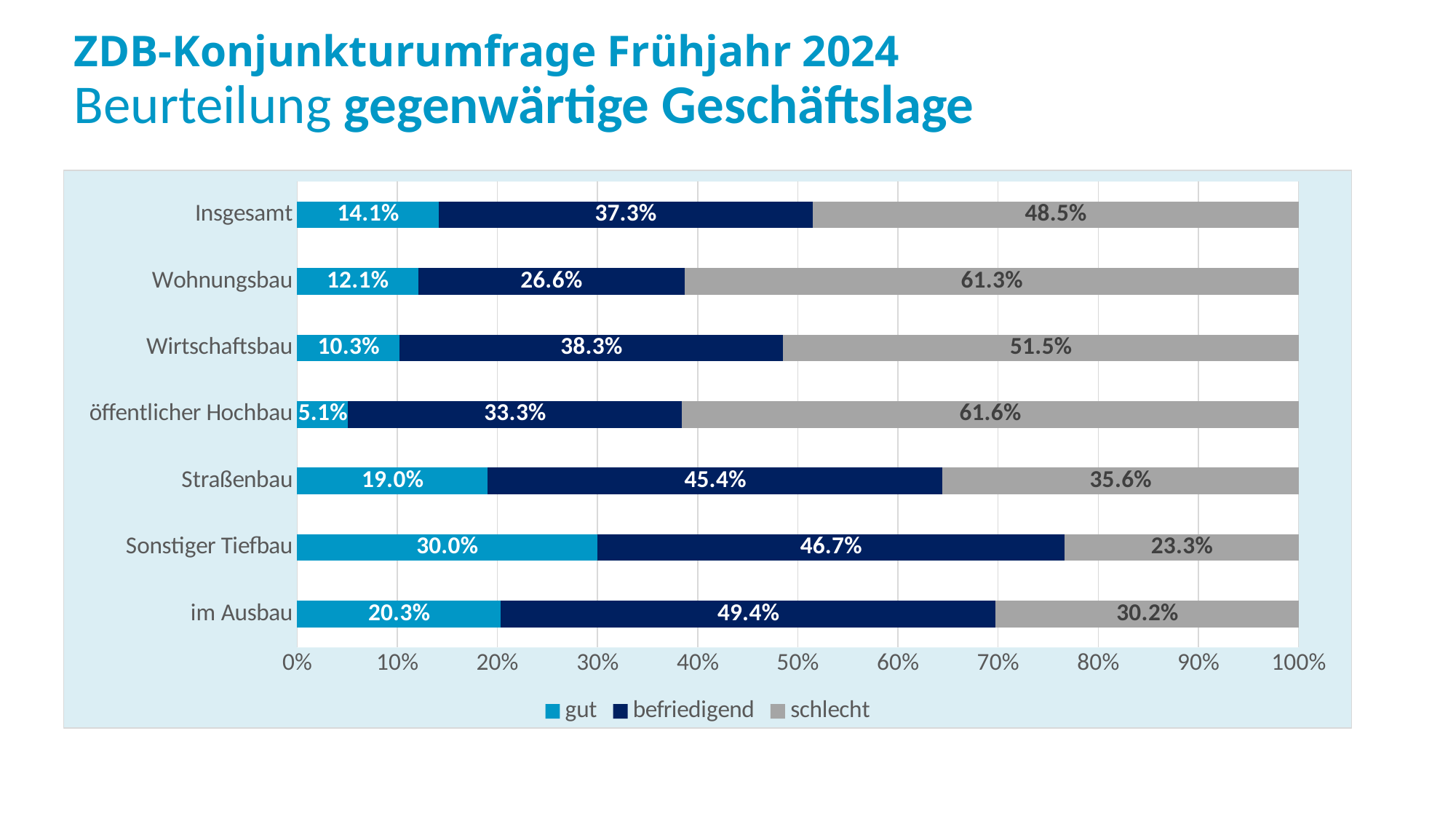
What kind of chart is shown on the slide? Stacked bar chart How many categories are shown on the chart? 7 What is the total of the three segments in the Sonstiger Tiefbau bar? 100.0% Which category has the lowest "schlecht" value? Sonstiger Tiefbau What is the "befriedigend" value for Straßenbau? 45.4% What is the "schlecht" value for Wohnungsbau? 61.3% Which is larger for Wirtschaftsbau: the "befriedigend" value or the "schlecht" value? schlecht What percentage of respondents rated the situation as "gut" in the Insgesamt category? 14.1% What is the difference between the "schlecht" and "gut" values for Insgesamt? 34.4 percentage points How many series does the legend list? 3 Which category has the highest "gut" value? Sonstiger Tiefbau Which category has the lowest "gut" value? öffentlicher Hochbau